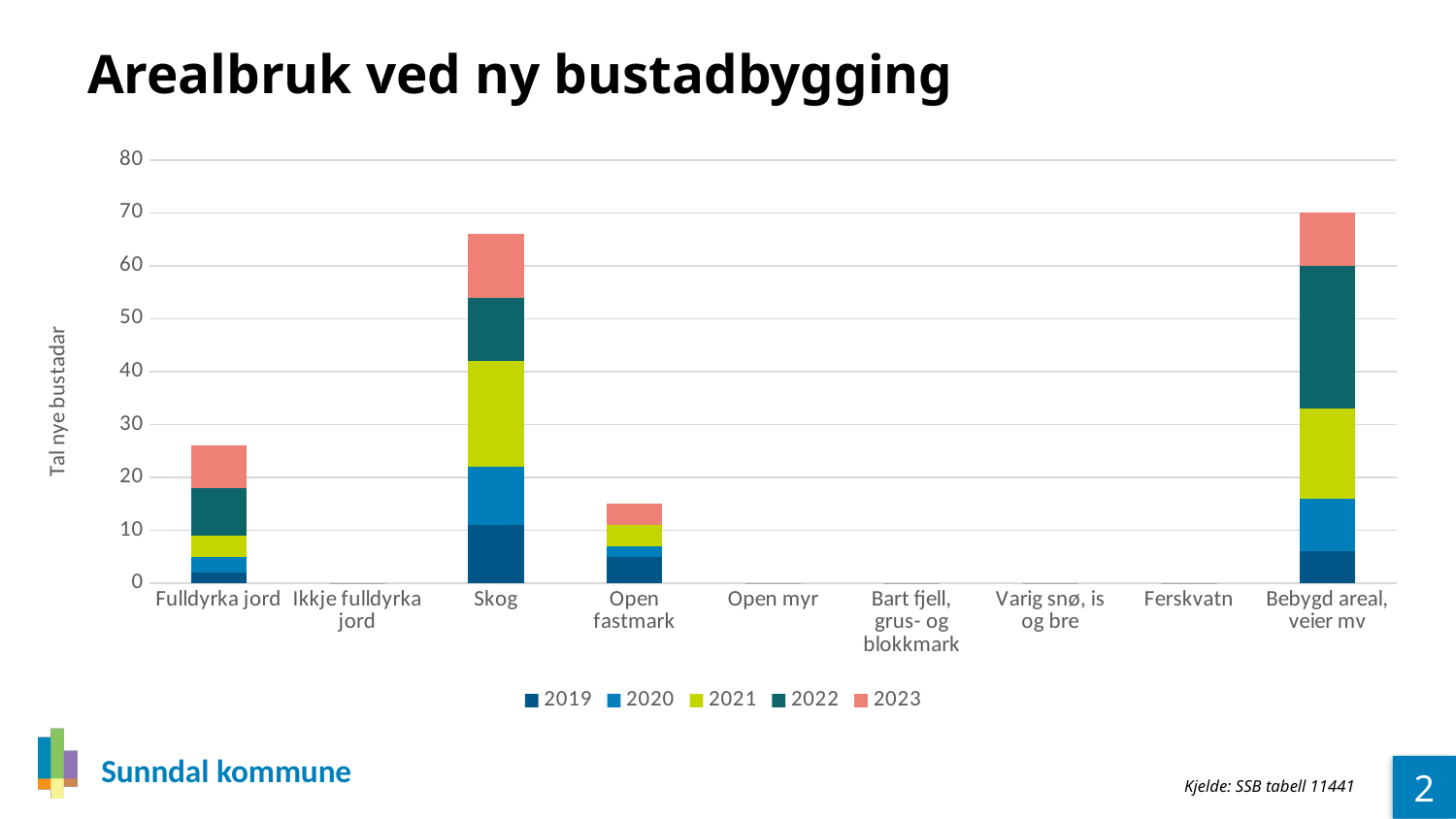
Is the total stacked value for Fulldyrka jord greater or less than 30? less Is the total stacked value for Skog greater or less than 60? greater What is the title of the chart? Arealbruk ved ny bustadbygging Is the total stacked value for Open fastmark greater or less than 20? less Which category has the tallest stacked bar? Bebygd areal, veier mv Which has a taller stacked bar, Skog or Fulldyrka jord? Skog How many series does the legend list? 5 Which has a taller stacked bar, Open fastmark or Fulldyrka jord? Fulldyrka jord What kind of chart is shown on the slide? Stacked bar chart What is the label on the y axis? Tal nye bustadar How many categories are shown along the x axis? 9